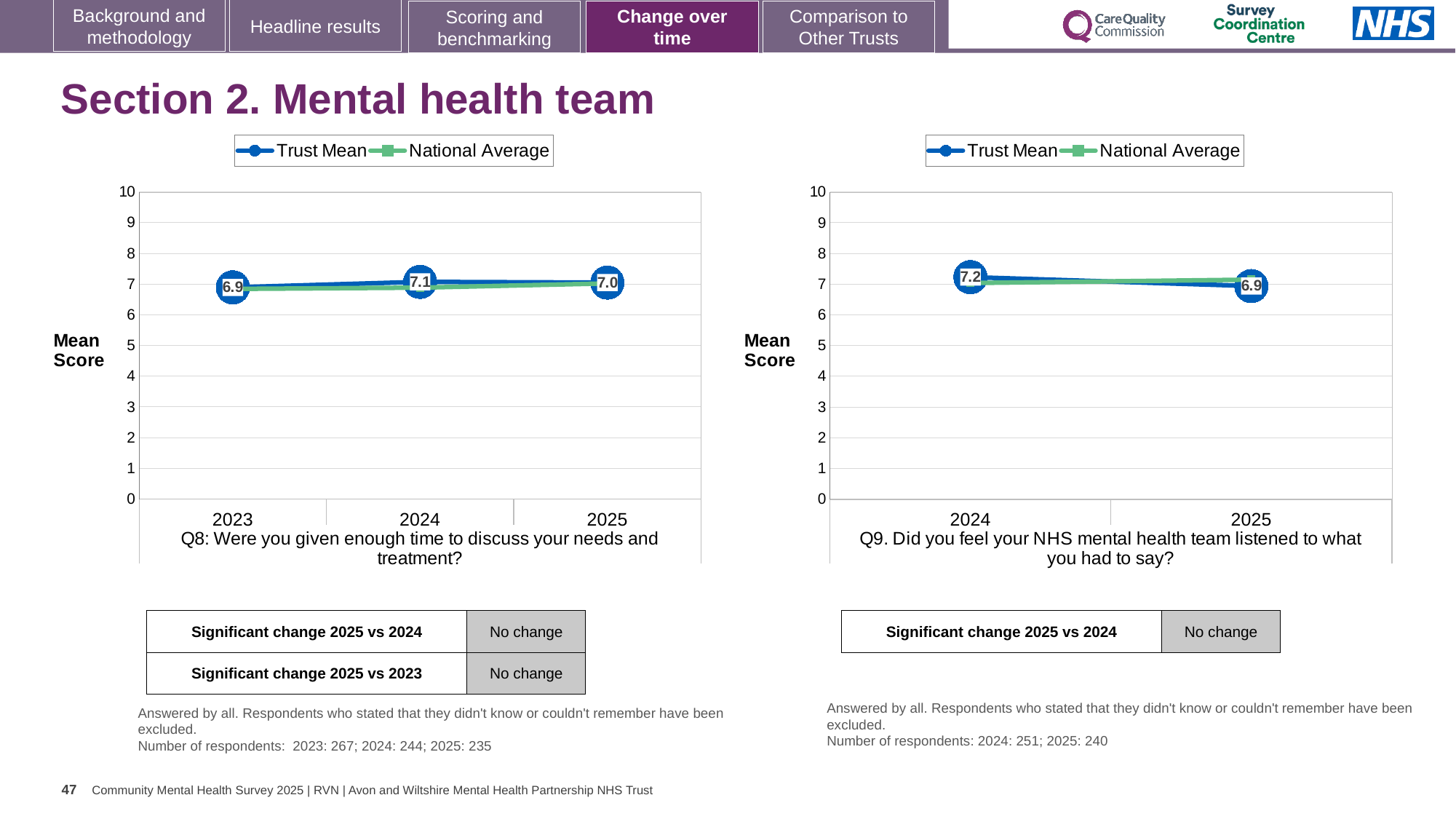
In the Q8 chart (left), how many years are plotted on the x axis? 3 In the Q9 chart (right), is the Trust Mean higher in 2024 or 2025? 2024 In the Q9 chart (right), what is the difference between the Trust Mean for 2024 and 2025? 0.3 In the Q8 chart (left), what is the Trust Mean for 2023? 6.9 In the Q9 chart (right), what is the Trust Mean for 2024? 7.2 In the Q9 chart (right), how many series does the legend list? 2 In the Q9 chart (right), what is the Trust Mean for 2025? 6.9 In the Q8 chart (left), which year has the highest Trust Mean? 2024 What type of chart is the Q8 chart (left)? Line chart In the Q8 chart (left), which year has the lowest Trust Mean? 2023 In the Q9 chart (right), does the Trust Mean rise or fall from 2024 to 2025? Fall In the Q8 chart (left), what is the Trust Mean for 2024? 7.1